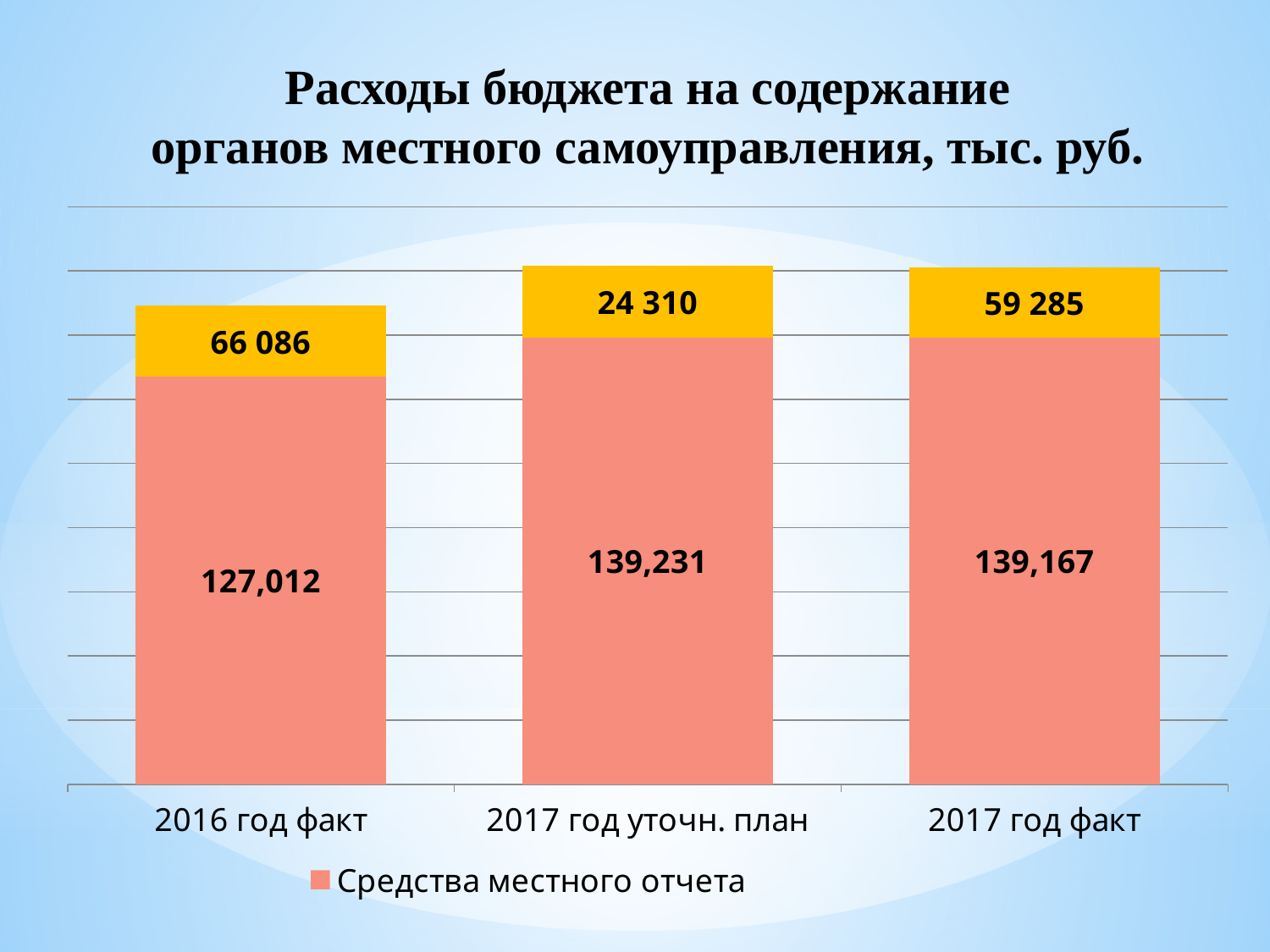
Which is larger for Средства местного отчета: 2016 год факт or 2017 год факт? 2017 год факт What is the value of the Средства местного отчета series for 2017 год факт? 139,167 What is the value of the Средства местного отчета series for 2016 год факт? 127,012 Which category has the lowest value for Средства местного отчета? 2016 год факт What value is printed on the yellow segment of the 2017 год факт bar? 59 285 How many categories are shown on the x axis? 3 What kind of chart is shown on the slide? Stacked bar chart How many series does the legend list? 1 What value is printed on the yellow segment of the 2016 год факт bar? 66 086 What value is printed on the yellow segment of the 2017 год уточн. план bar? 24 310 What is the value of the Средства местного отчета series for 2017 год уточн. план? 139,231 What is the difference between the Средства местного отчета values for 2017 год уточн. план and 2016 год факт? 12,219